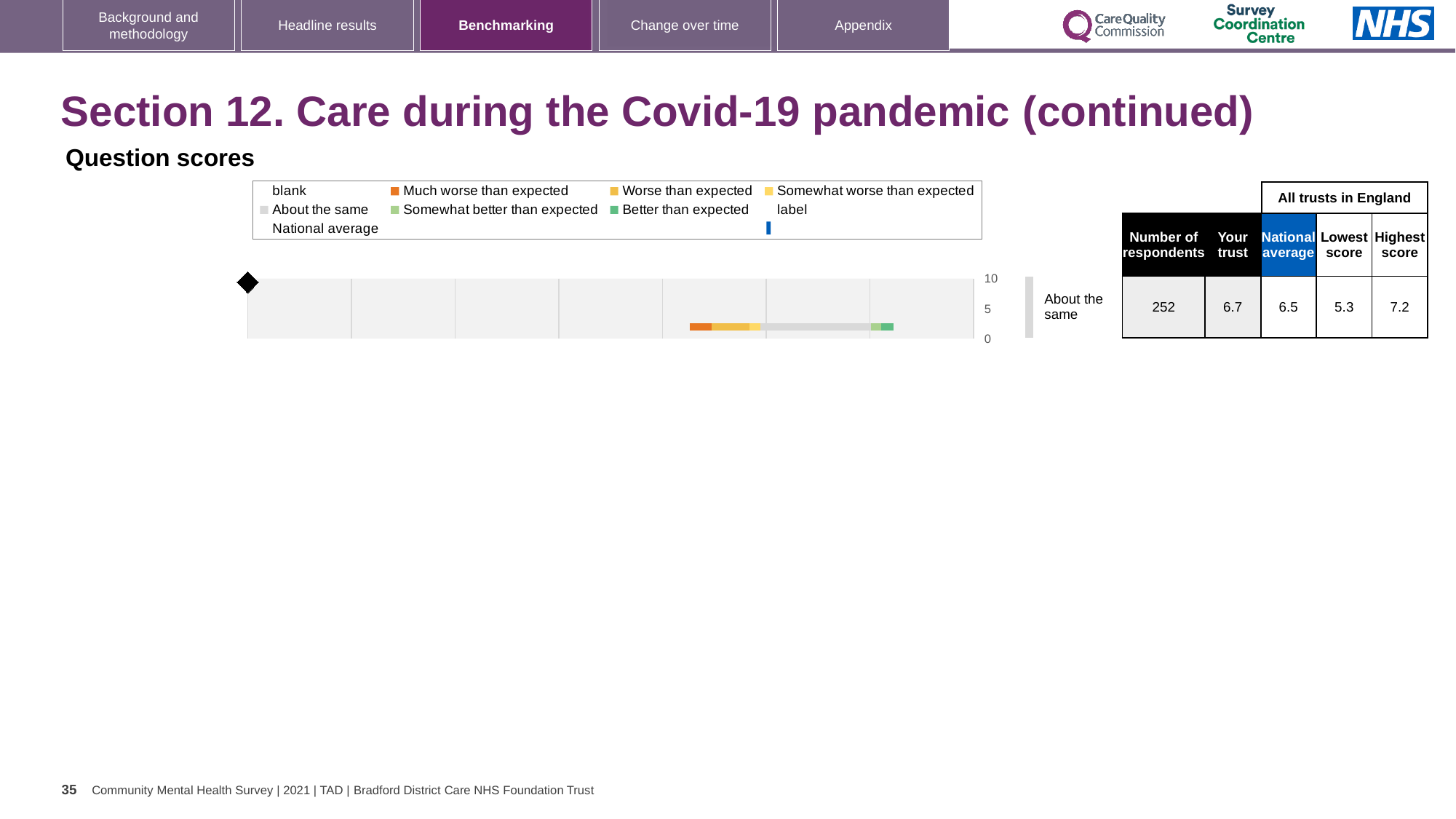
What colour represents 'Much worse than expected' in the legend? orange What is the Highest score among all trusts in England? 7.2 What is the score for Your trust shown in the table? 6.7 How many respondents are shown for this question? 252 Which benchmarking category is the trust's score placed in, according to the label next to the chart? About the same What is the difference between the Highest score and the Lowest score? 1.9 What is the Lowest score among all trusts in England? 5.3 What kind of chart is used to show the question score benchmarking? bar chart What is the National average score shown in the table? 6.5 What is the highest value shown on the chart's axis? 10 What is the difference between the Your trust score and the National average score? 0.2 Which is higher, the Your trust score or the National average score? Your trust